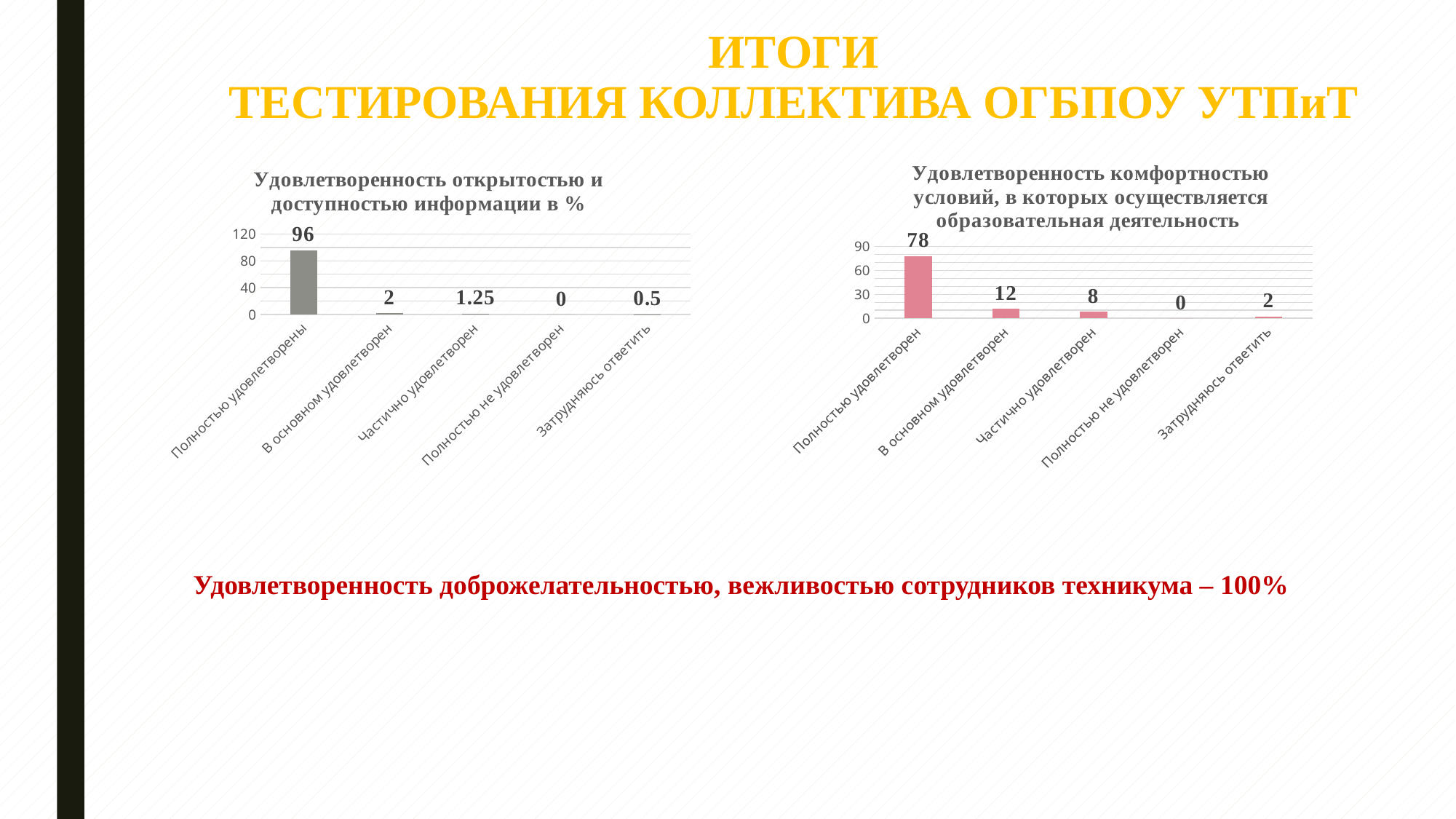
In the right chart (Удовлетворенность комфортностью условий), what is the value for Частично удовлетворен? 8 In the right chart (Удовлетворенность комфортностью условий), what is the value for В основном удовлетворен? 12 In the left chart (Удовлетворенность открытостью и доступностью информации в %), what is the value for Полностью удовлетворены? 96 In the right chart (Удовлетворенность комфортностью условий), what is the difference between the values for Полностью удовлетворен and В основном удовлетворен? 66 What type of chart is the right chart (Удовлетворенность комфортностью условий)? Bar chart In the right chart (Удовлетворенность комфортностью условий), which category has the highest value? Полностью удовлетворен In the left chart (Удовлетворенность открытостью и доступностью информации в %), which category has the lowest value? Полностью не удовлетворен How many categories are shown in the left chart (Удовлетворенность открытостью и доступностью информации в %)? 5 In the left chart (Удовлетворенность открытостью и доступностью информации в %), what is the value for Затрудняюсь ответить? 0.5 In the left chart (Удовлетворенность открытостью и доступностью информации в %), what is the difference between the values for В основном удовлетворен and Частично удовлетворен? 0.75 In the left chart (Удовлетворенность открытостью и доступностью информации в %), what is the value for Частично удовлетворен? 1.25 In the right chart (Удовлетворенность комфортностью условий), which is larger: the value for Частично удовлетворен or the value for Затрудняюсь ответить? Частично удовлетворен